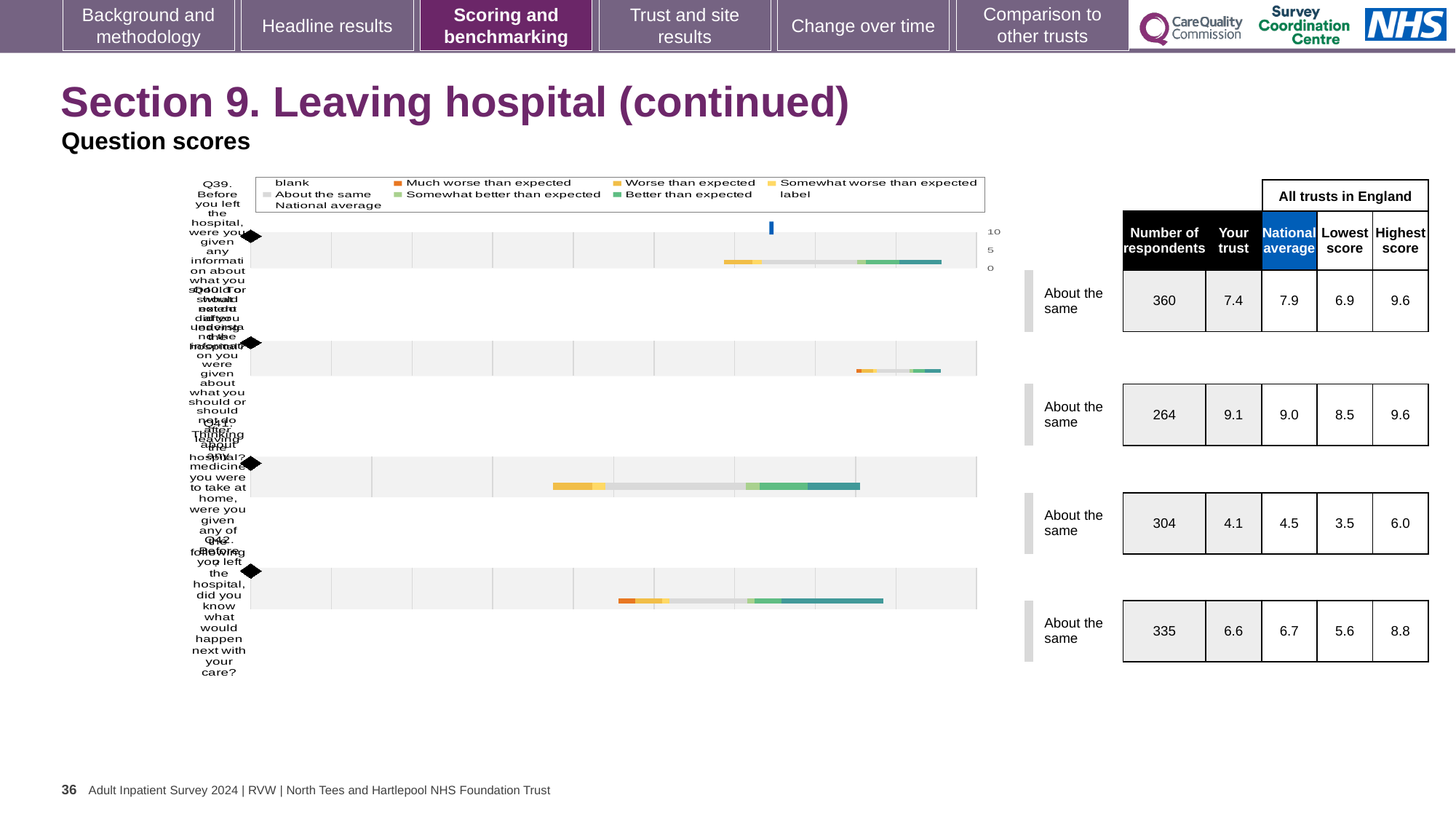
How many questions (bars) are plotted in the chart? 4 Which row of the table has the lowest 'Your trust' score? third row (4.1) What is the highest value shown on the chart's axis? 10 Which row of the table has the highest 'Your trust' score? second row (9.1) What kind of chart is shown on the slide? bar chart What colour does the legend use for 'Much worse than expected'? orange What benchmark category is shown next to each of the four questions? About the same In the table beside the chart, what is the 'Your trust' score in the first row (Q39)? 7.4 In the first row of the table (Q39), what is the difference between the highest score and the lowest score? 2.7 In the table beside the chart, what is the 'National average' in the first row (Q39)? 7.9 In the first row of the table (Q39), which is larger: the 'Your trust' score or the 'National average'? National average In the table beside the chart, what is the number of respondents in the fourth row (Q42)? 335